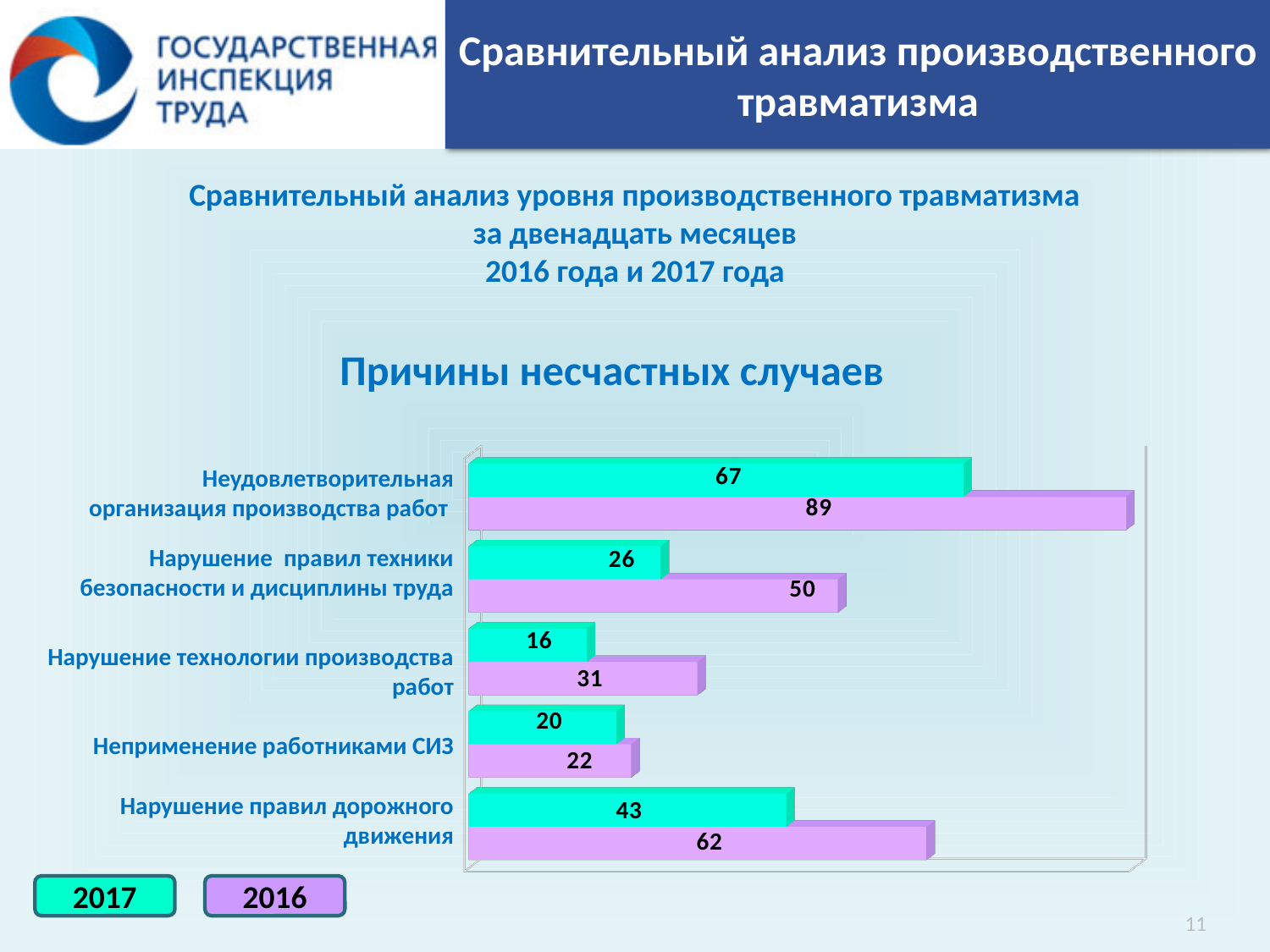
How many categories are shown in the chart? 5 Which colour represents the year 2017 in the chart? Turquoise (green-blue) Which is larger: the 2017 value for «Нарушение правил дорожного движения» or the 2017 value for «Нарушение правил техники безопасности и дисциплины труда»? Нарушение правил дорожного движения What is the difference between the 2016 and 2017 values for «Нарушение правил дорожного движения»? 19 Which category has the lowest 2017 value? Нарушение технологии производства работ What is the 2016 value for «Неприменение работниками СИЗ»? 22 What kind of chart is shown on the slide? Bar chart Which category has the highest 2016 value? Неудовлетворительная организация производства работ How many series does the legend list? 2 What is the 2017 value for «Неудовлетворительная организация производства работ»? 67 What is the difference between the 2016 and 2017 values for «Нарушение технологии производства работ»? 15 What is the 2016 value for «Нарушение правил техники безопасности и дисциплины труда»? 50